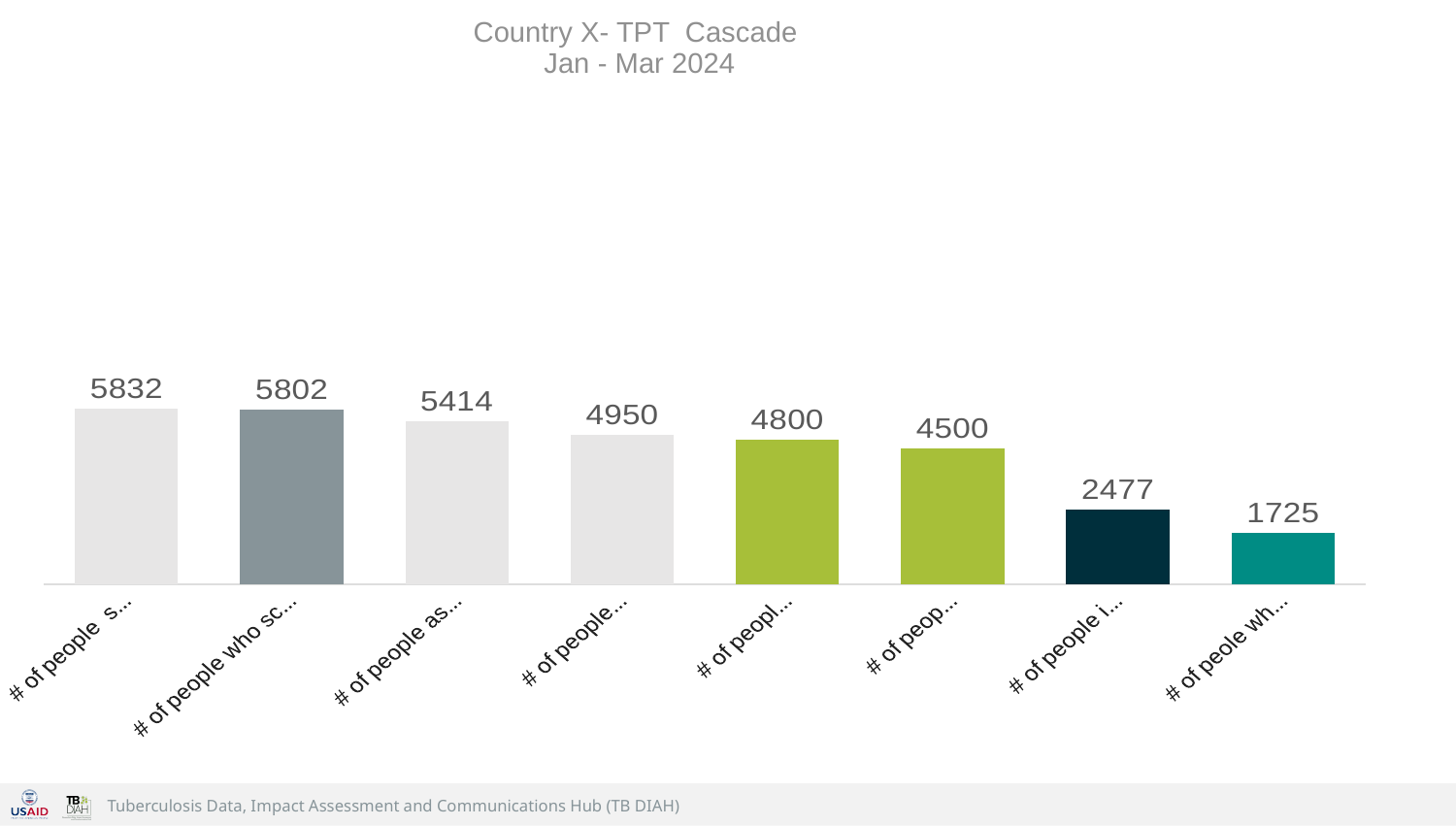
Do the bar values rise or fall from left to right across the chart? fall What is the difference between the first bar (5832) and the last bar (1725)? 4107 What is the highest value shown in the chart? 5832 What is the value of the second bar from the left? 5802 What kind of chart is shown on the slide? bar chart Which is larger, the fifth bar or the sixth bar? the fifth bar (4800) How many bars are plotted in the chart? 8 What is the value of the seventh bar from the left? 2477 What is the lowest value shown in the chart? 1725 What is the title of the chart? Country X- TPT Cascade Jan - Mar 2024 What is the value of the last (rightmost) bar? 1725 What is the value of the first (leftmost) bar? 5832